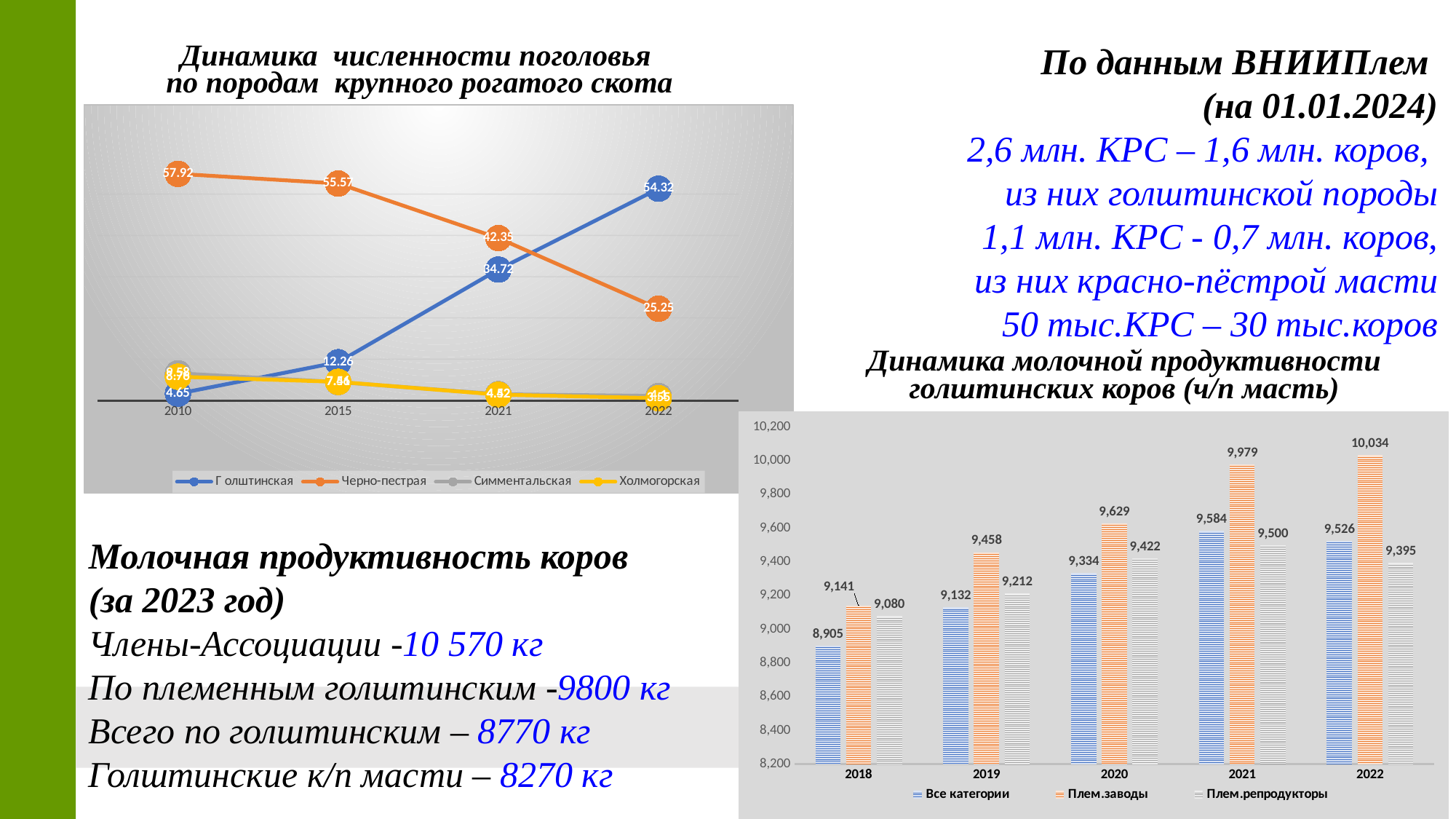
In the chart 'Динамика численности поголовья по породам крупного рогатого скота', how many series does the legend list? 4 What kind of chart is 'Динамика молочной продуктивности голштинских коров (ч/п масть)'? bar chart In the chart 'Динамика численности поголовья по породам крупного рогатого скота', what is the value for Черно-пестрая in 2010? 57.92 In the chart 'Динамика молочной продуктивности голштинских коров (ч/п масть)', how many years are shown on the x axis? 5 In the chart 'Динамика молочной продуктивности голштинских коров (ч/п масть)', what is the difference between Плем.заводы and Все категории in 2021? 395 In the chart 'Динамика молочной продуктивности голштинских коров (ч/п масть)', what is the value for Плем.заводы in 2022? 10,034 In the chart 'Динамика численности поголовья по породам крупного рогатого скота', does the Голштинская series rise or fall from 2010 to 2022? rise In the chart 'Динамика численности поголовья по породам крупного рогатого скота', what is the difference between the Черно-пестрая values in 2010 and 2022? 32.67 In the chart 'Динамика молочной продуктивности голштинских коров (ч/п масть)', what is the value for Все категории in 2018? 8,905 In the chart 'Динамика молочной продуктивности голштинских коров (ч/п масть)', which year has the highest value for Плем.репродукторы? 2021 In the chart 'Динамика молочной продуктивности голштинских коров (ч/п масть)', which is larger in 2020: Все категории or Плем.репродукторы? Плем.репродукторы In the chart 'Динамика численности поголовья по породам крупного рогатого скота', what is the value for Голштинская in 2022? 54.32